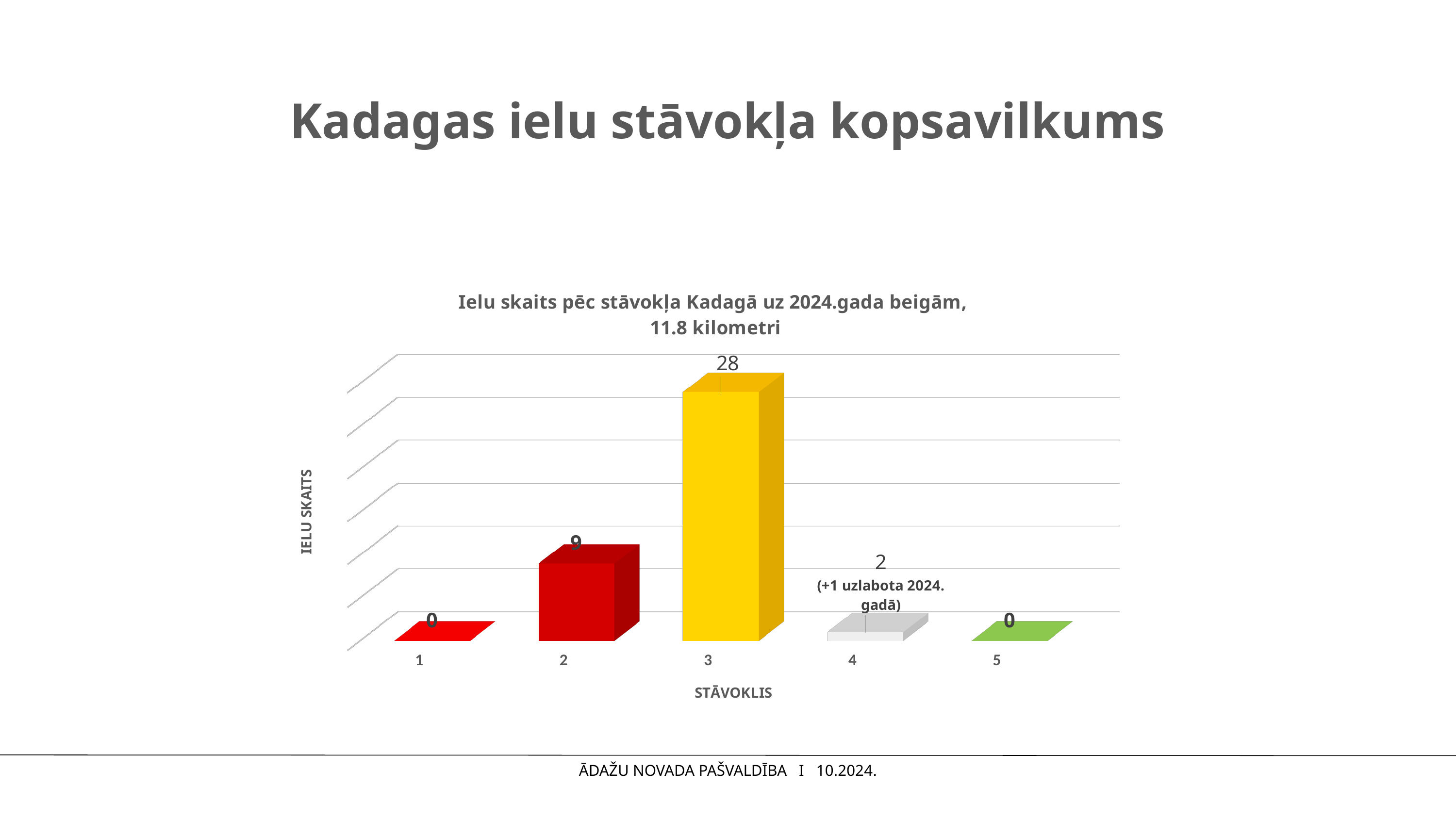
What is the title of the chart? Ielu skaits pēc stāvokļa Kadagā uz 2024.gada beigām, 11.8 kilometri What is the value for category 2? 9 What kind of chart is shown on the slide? bar chart What is the difference between the values for category 3 and category 2? 19 What is the label of the x axis? STĀVOKLIS Which is larger, the value for category 2 or the value for category 4? category 2 What is the value for category 3? 28 Which category has the highest value? 3 What is the value for category 5? 0 What is the difference between the values for category 2 and category 4? 7 How many categories are shown on the x axis? 5 What is the value for category 4? 2